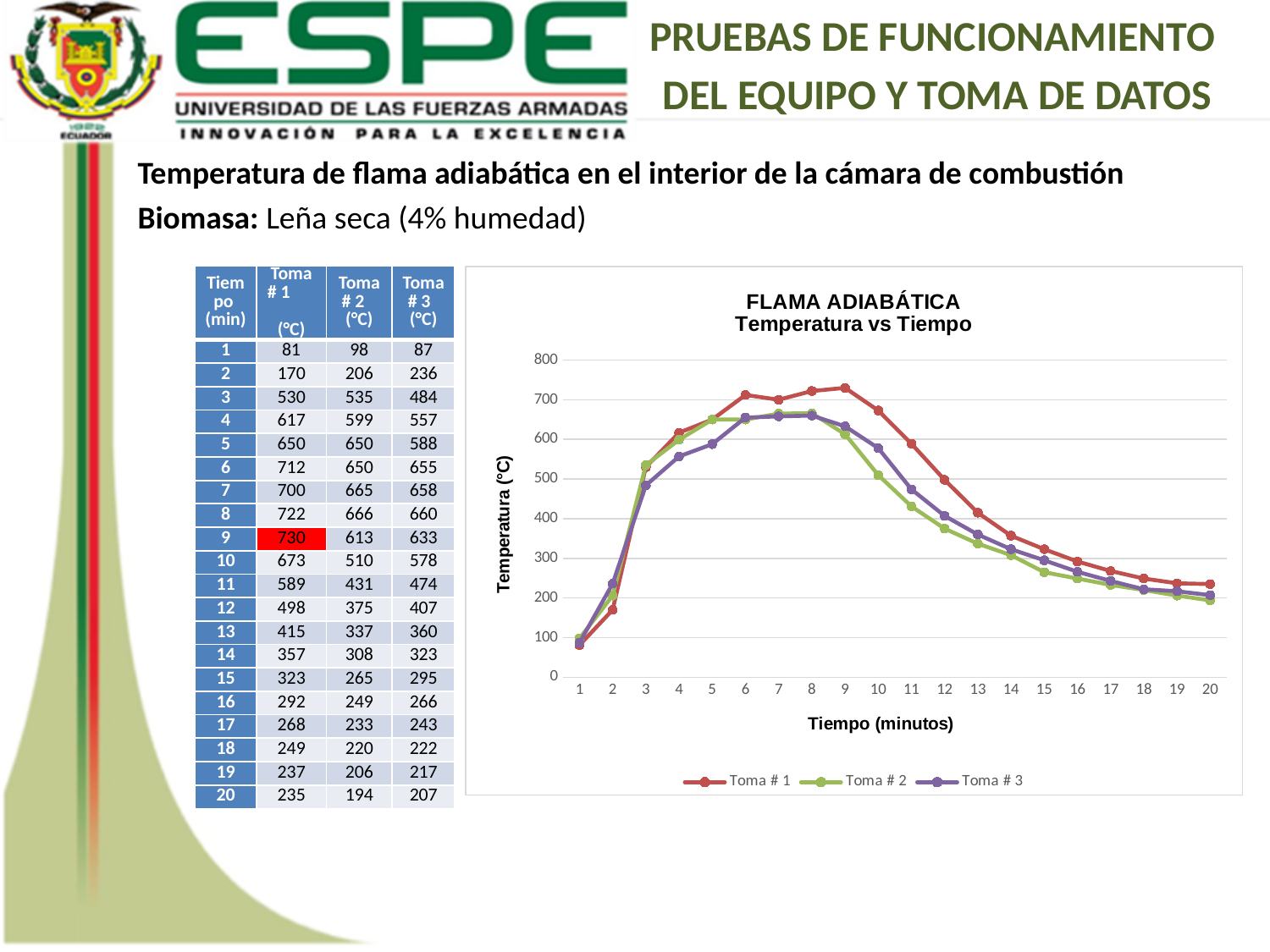
At which minute does Toma # 1 reach its highest temperature? 9 What is the temperature for Toma # 2 at minute 10? 510 What is the title of the chart? FLAMA ADIABÁTICA Temperatura vs Tiempo Is the value for Toma # 1 at minute 9 greater or less than 700? greater What is the difference between Toma # 1 and Toma # 2 at minute 10? 163 How many series does the chart legend list? 3 How many time points are plotted along the x axis of the chart? 20 What kind of chart is shown on the slide? line chart What is the temperature for Toma # 1 at minute 9? 730 Which series has the lowest temperature at minute 20? Toma # 2 What is the temperature for Toma # 3 at minute 20? 207 At minute 2, which is larger: Toma # 3 or Toma # 1? Toma # 3